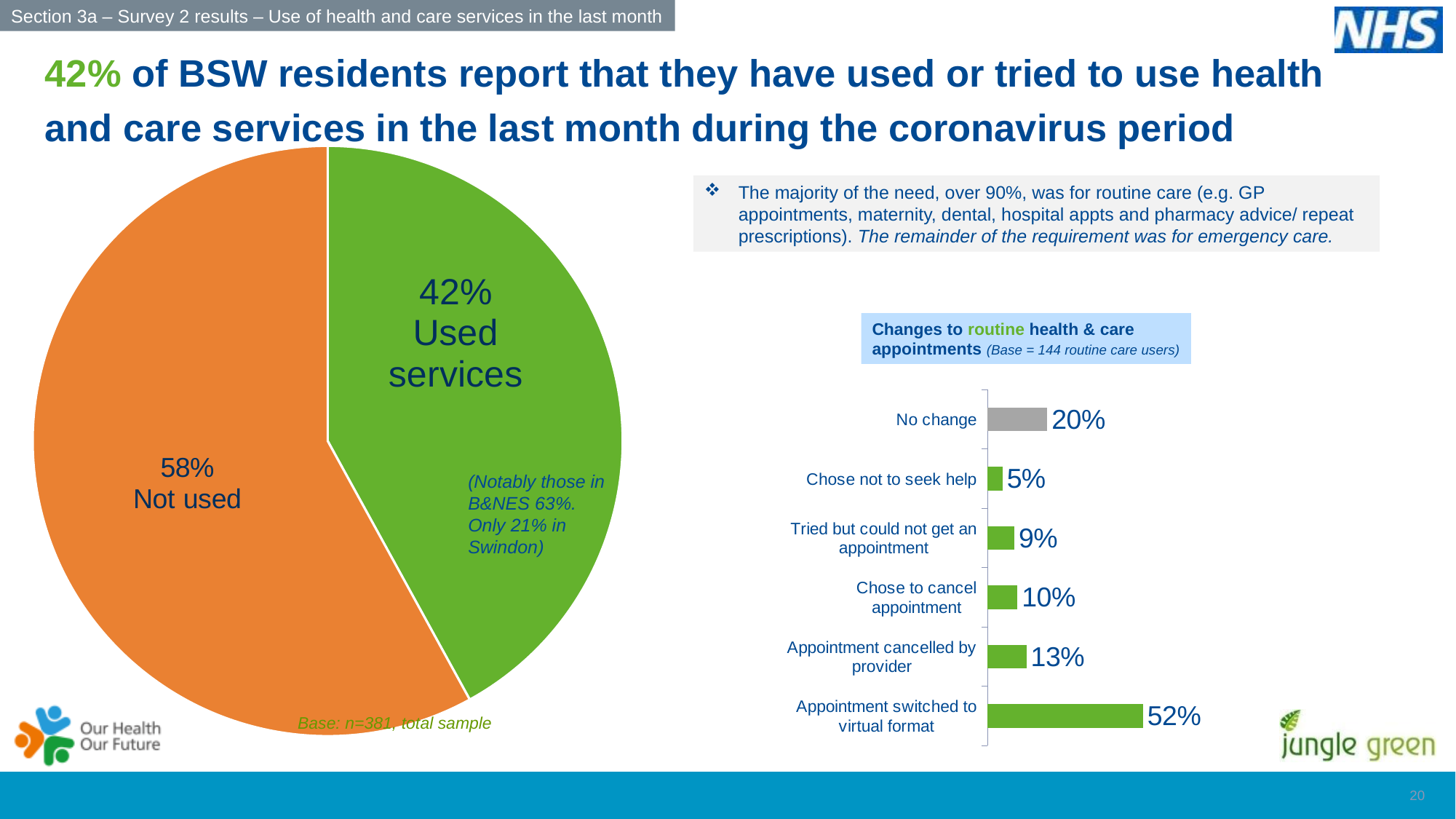
In the 'Changes to routine health & care appointments' chart, what is the value for 'Appointment switched to virtual format'? 52% What kind of chart is the 'Changes to routine health & care appointments' chart? Bar chart In the 'Changes to routine health & care appointments' chart, what is the difference between 'Appointment cancelled by provider' and 'Chose to cancel appointment'? 3% In the 'Changes to routine health & care appointments' chart, which bar is shown in grey rather than green? No change In the pie chart on the left, what share of residents report they used services? 42% In the 'Changes to routine health & care appointments' chart, what is the value for 'No change'? 20% How many categories are shown in the 'Changes to routine health & care appointments' chart? 6 In the pie chart on the left, what share of residents report they did not use services? 58% In the 'Changes to routine health & care appointments' chart, which category has the lowest value? Chose not to seek help In the 'Changes to routine health & care appointments' chart, which category has the highest value? Appointment switched to virtual format In the pie chart on the left, which slice is larger, 'Used services' or 'Not used'? Not used What kind of chart is the chart on the left of the slide? Pie chart